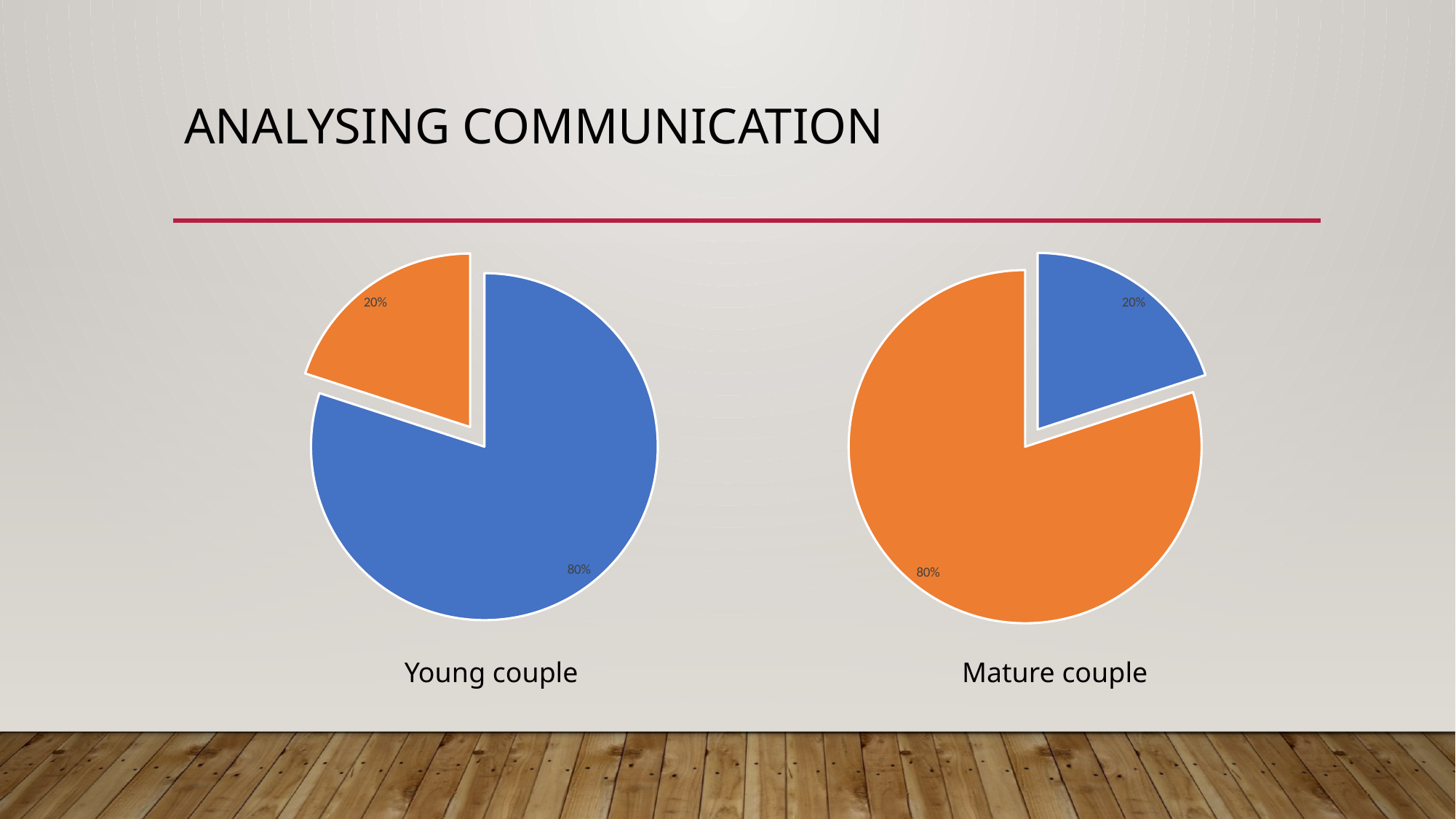
How many pie charts are on the slide? 2 What kind of chart is shown under the label "Young couple"? Pie chart What is the title of the slide containing the two pie charts? Analysing Communication How many slices does the "Young couple" pie chart have? 2 In the "Young couple" pie chart, what share does the orange slice have? 20% In the "Mature couple" pie chart, which colour slice is the smallest? Blue In the "Young couple" pie chart, what is the difference between the blue slice and the orange slice? 60% In the "Young couple" pie chart, which colour slice is the largest? Blue In the "Mature couple" pie chart, what share does the orange slice have? 80% In the "Mature couple" pie chart, what share does the blue slice have? 20% In the "Young couple" pie chart, what share does the blue slice have? 80% In the "Mature couple" pie chart, is the orange slice larger or smaller than the blue slice? Larger